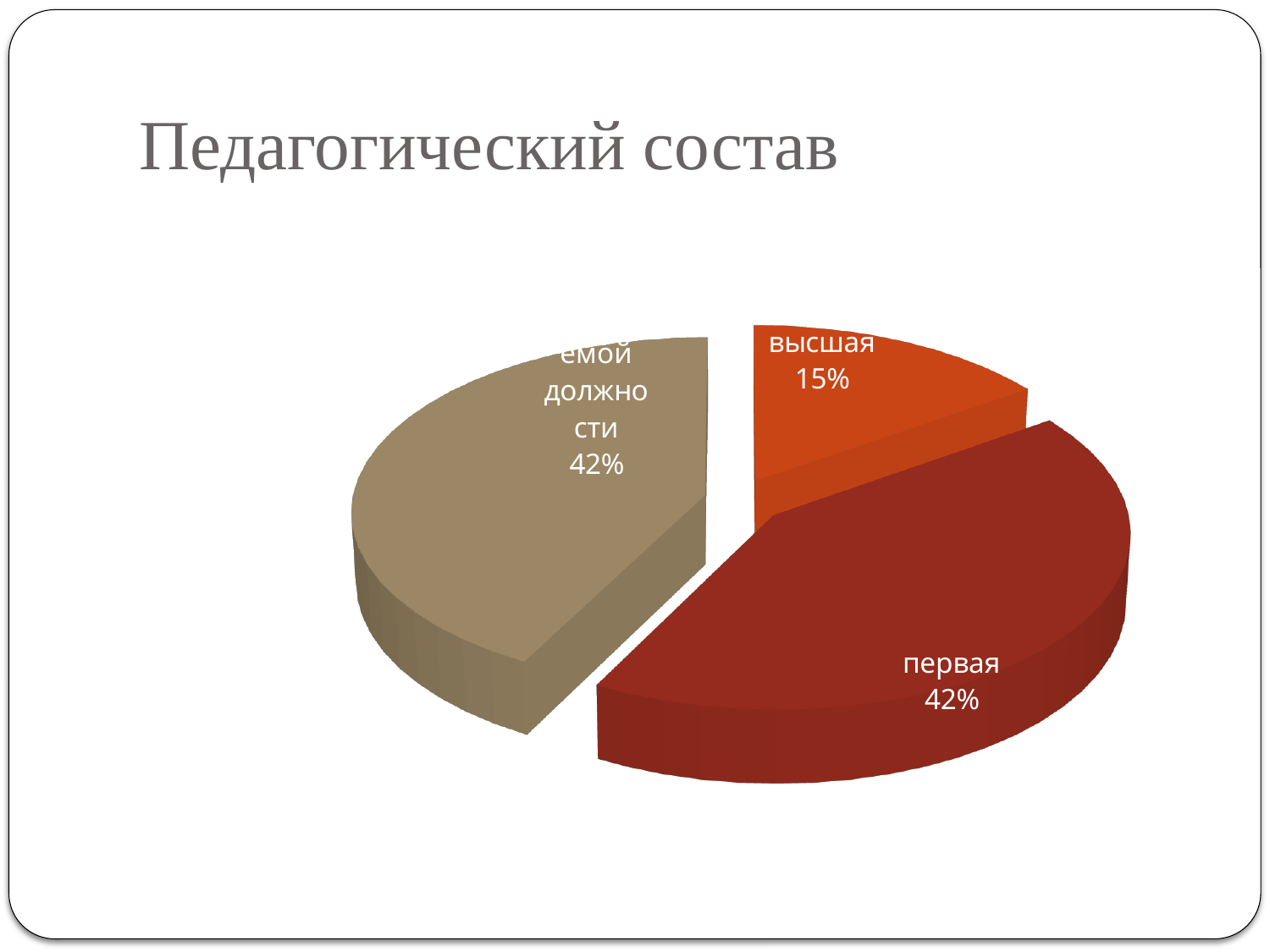
By how many percentage points does the "первая" slice exceed the "высшая" slice? 27 What colour is the slice labelled "высшая"? orange What is the title of the chart on the slide? Педагогический состав What percentage is shown for the slice labelled "высшая"? 15% Which slice of the pie chart has the smallest share? высшая How many slices does the pie chart have? 3 Which slice is larger, "первая" or "высшая"? первая What kind of chart is shown on the slide? pie chart What share of the pie does the "высшая" slice represent? 15% What percentage is shown for the slice labelled "первая"? 42%